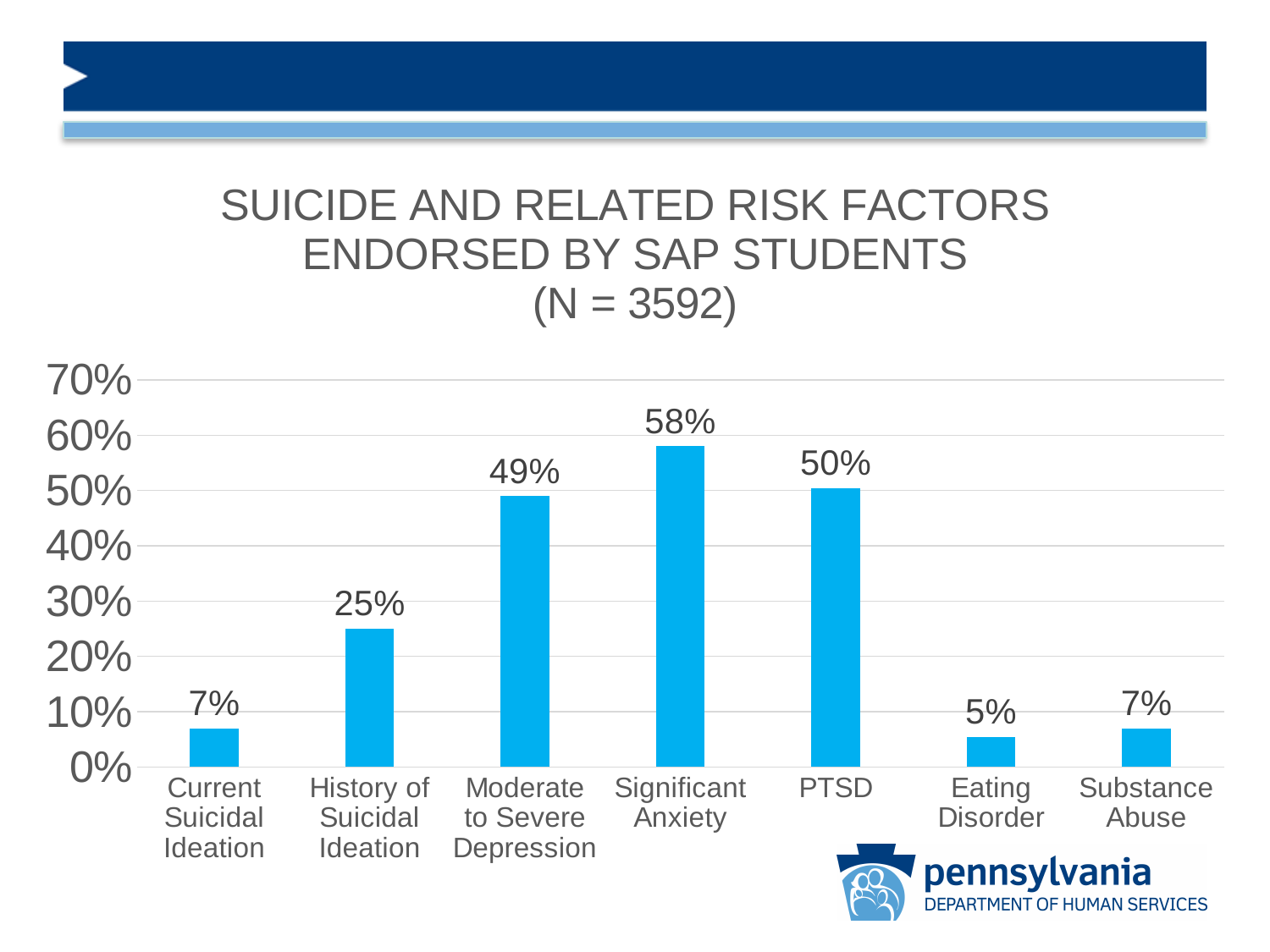
Which risk factor has the highest percentage? Significant Anxiety What is the value shown for History of Suicidal Ideation? 25% What is the difference between the percentages for History of Suicidal Ideation and Current Suicidal Ideation? 18% Which risk factor has the lowest percentage? Eating Disorder What kind of chart is shown on the slide? Bar chart What percentage of SAP students endorsed Significant Anxiety? 58% What is the value shown for Eating Disorder? 5% Which is larger, the value for PTSD or the value for Moderate to Severe Depression? PTSD What sample size (N) is given in the chart title? 3592 What is the difference between the percentages for Significant Anxiety and Moderate to Severe Depression? 9% How many risk factor categories are shown on the chart? 7 What percentage of SAP students endorsed PTSD? 50%